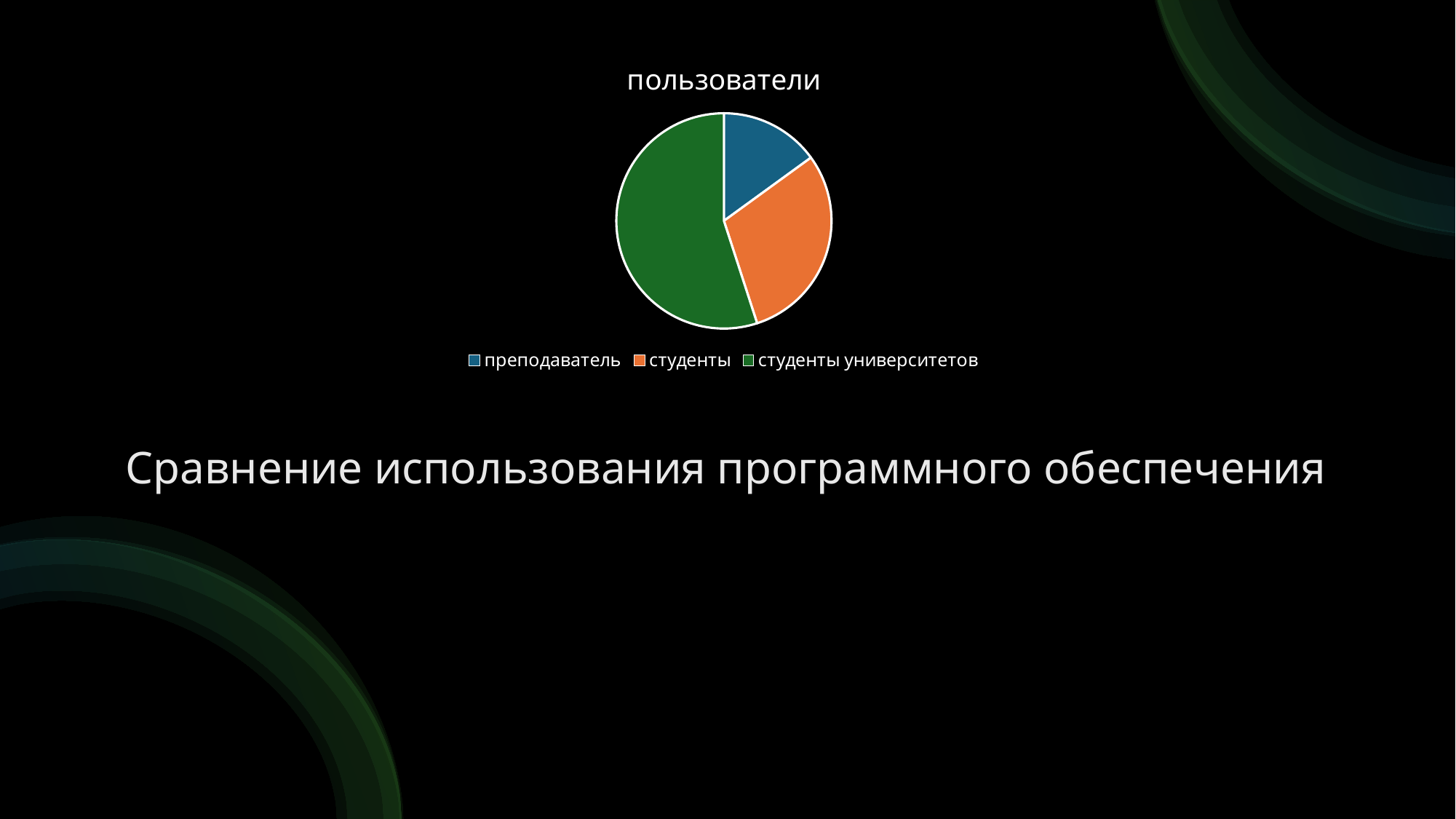
How many slices does the pie chart have? 3 Which colour represents студенты университетов in the pie chart? green Does the slice for студенты университетов take up more or less than half of the pie? more What is the title of the chart? пользователи Which slice is larger: студенты университетов or студенты? студенты университетов Which category has the largest slice of the pie? студенты университетов How many entries does the legend list? 3 What kind of chart is shown on the slide? pie chart Which category has the smallest slice of the pie? преподаватель Which slice is larger: студенты or преподаватель? студенты